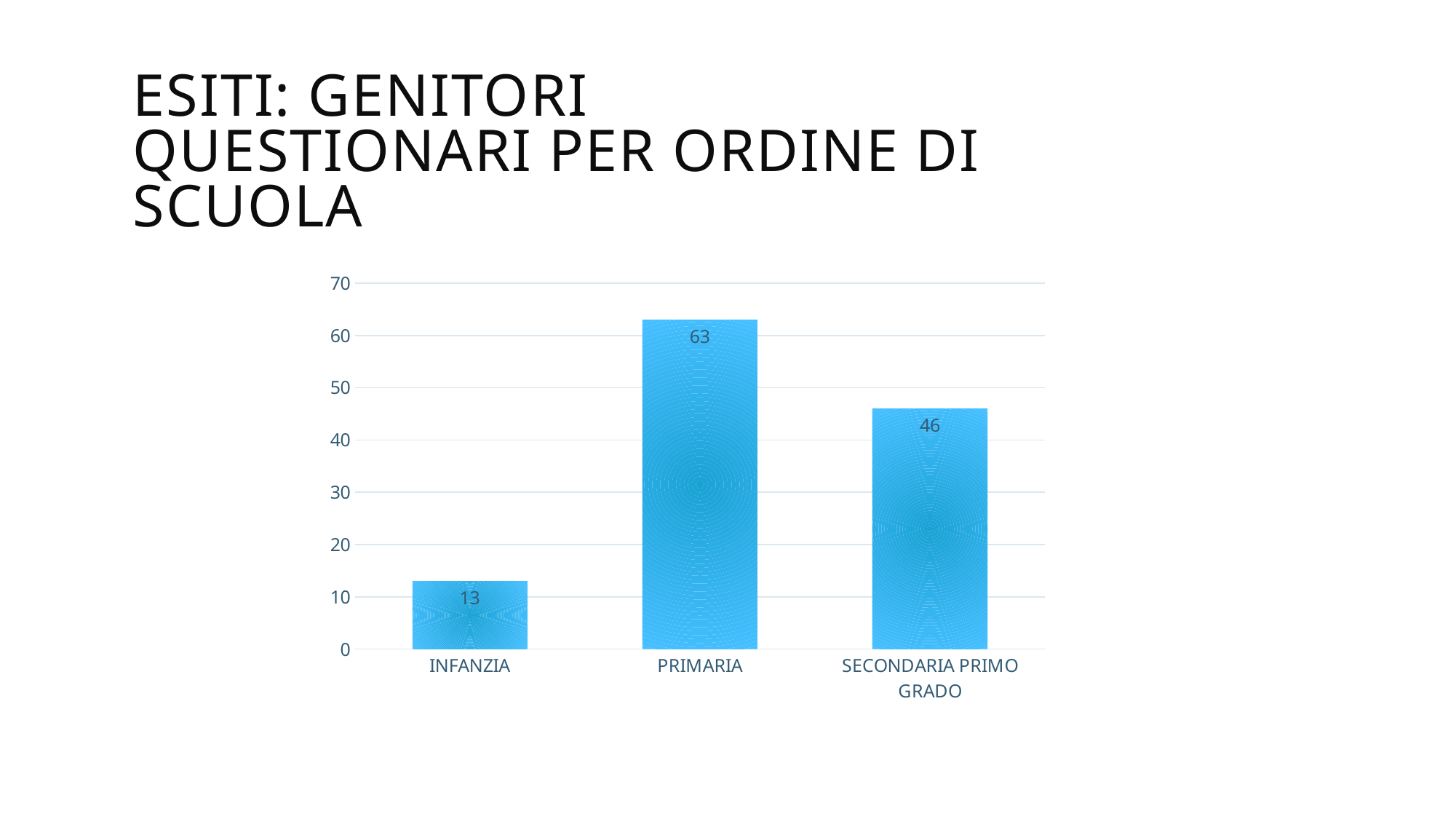
What kind of chart is shown on the slide? bar chart What is the value for SECONDARIA PRIMO GRADO? 46 Is the value for PRIMARIA greater or less than 60? greater Which is larger, the value for INFANZIA or the value for SECONDARIA PRIMO GRADO? SECONDARIA PRIMO GRADO What is the difference between the values for SECONDARIA PRIMO GRADO and INFANZIA? 33 Which category has the lowest value? INFANZIA What is the value for INFANZIA? 13 How many categories are shown on the x axis? 3 What is the value for PRIMARIA? 63 What is the difference between the values for PRIMARIA and SECONDARIA PRIMO GRADO? 17 What is the highest value shown on the vertical axis? 70 Which category has the highest value? PRIMARIA